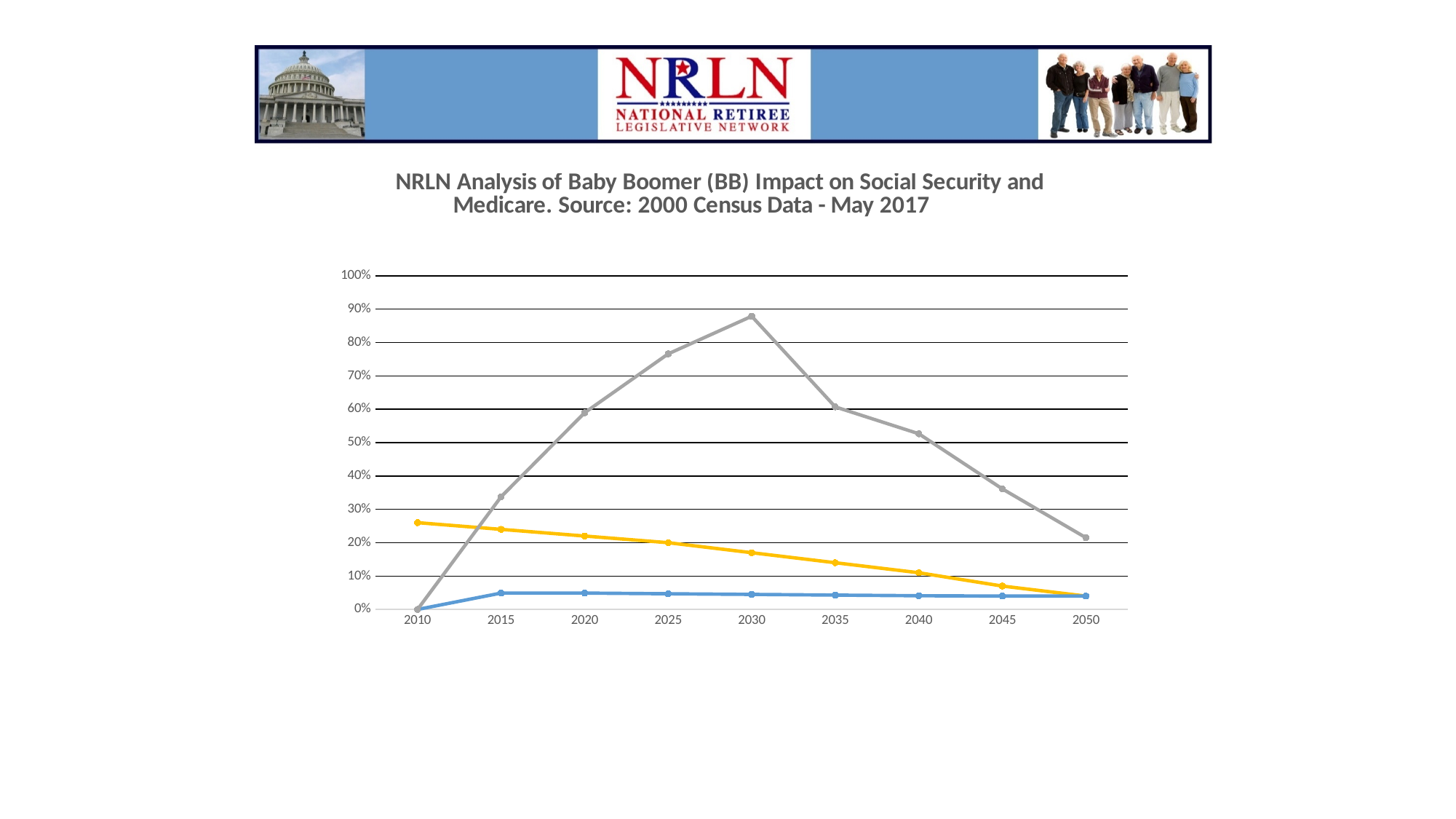
In 2010, which line has the larger value, the yellow line or the gray line? yellow line Is the value of the yellow line in 2050 greater or less than 10%? less Is the value of the gray line in 2045 greater or less than 40%? less In which year is the yellow line at its highest value? 2010 What kind of chart is shown on the slide? line chart Is the value of the gray line in 2030 greater or less than 80%? greater What is the title of the chart? NRLN Analysis of Baby Boomer (BB) Impact on Social Security and Medicare. Source: 2000 Census Data - May 2017 In which year does the gray line reach its highest value? 2030 How many lines are plotted on the chart? 3 Does the yellow line rise or fall from 2010 to 2050? fall How many years are marked along the x axis of the chart? 9